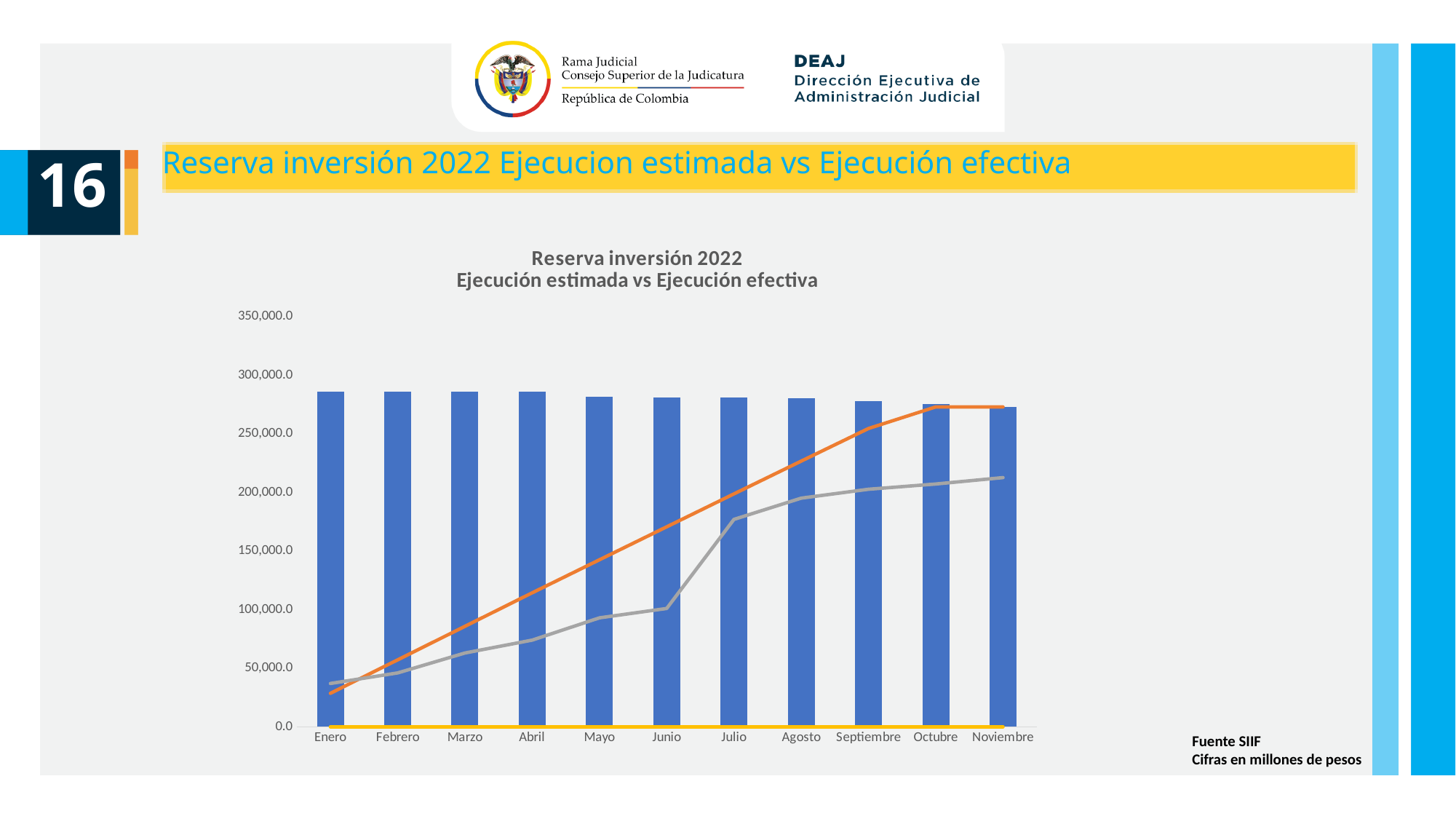
Does the orange line rise or fall from Enero to Octubre? rise What kind of chart is shown on the slide? A combination chart with bars and two lines How many months are shown on the x axis of the chart? 11 Is the bar for Enero greater or less than 250,000.0? greater Which bar is taller, Enero or Noviembre? Enero Is the orange line's value for Octubre greater or less than 250,000.0? greater Is the grey line's value for Junio greater or less than 150,000.0? less In Julio, which is higher, the orange line or the grey line? The orange line What is the title of the chart? Reserva inversión 2022 Ejecución estimada vs Ejecución efectiva According to the note on the slide, in what units are the figures expressed? Millones de pesos